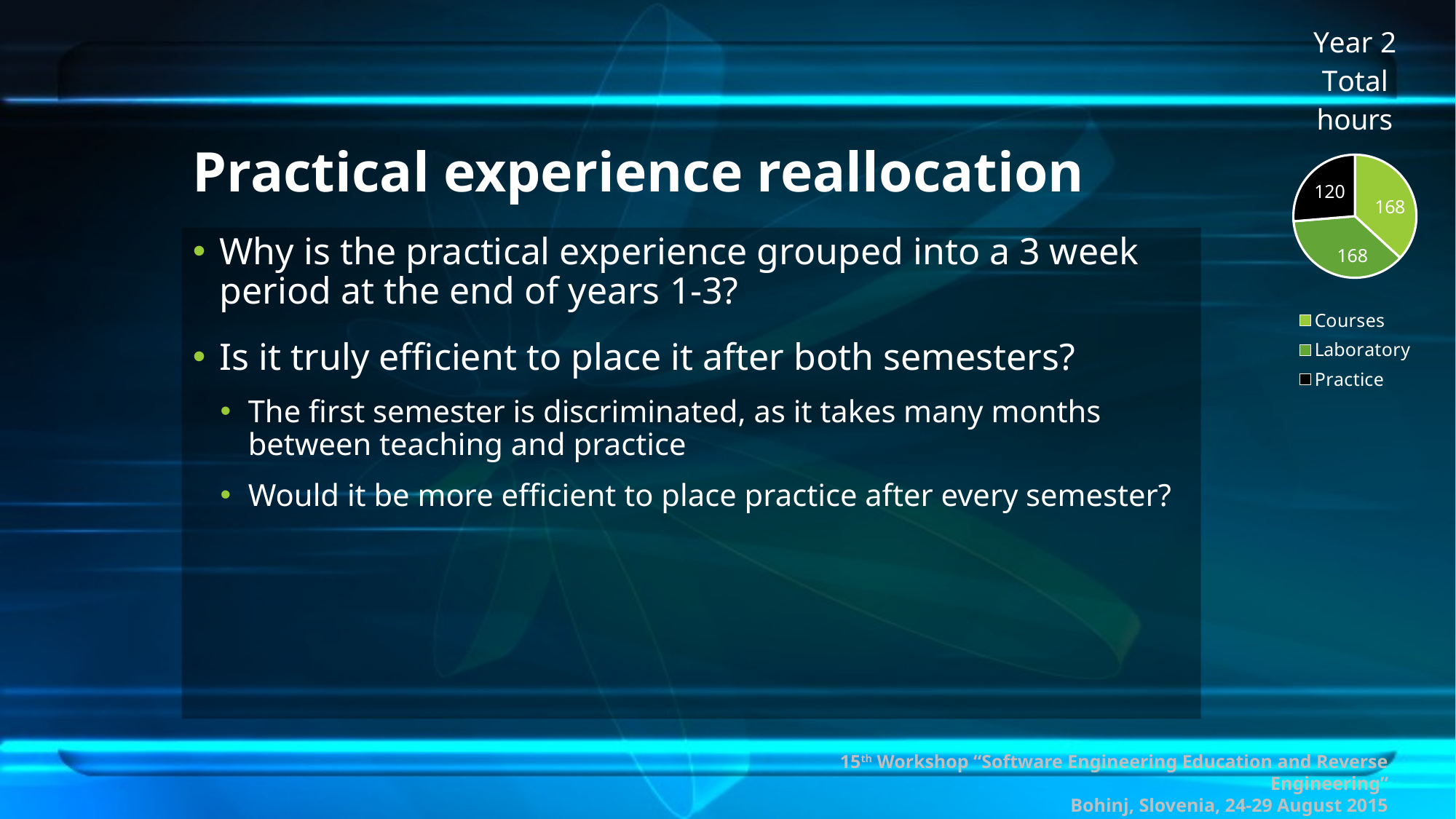
How many entries does the legend of the Year 2 Total hours chart list? 3 How many slices does the Year 2 Total hours pie chart have? 3 What is the value for Laboratory in the Year 2 Total hours pie chart? 168 What is the total of all slices in the Year 2 Total hours pie chart? 456 Which is larger in the Year 2 Total hours chart, Laboratory or Practice? Laboratory Which legend entry in the Year 2 Total hours chart is shown in black? Practice What is the difference between the Courses value and the Practice value in the Year 2 Total hours chart? 48 What is the value for Courses in the Year 2 Total hours pie chart? 168 What kind of chart is shown on the slide? Pie chart Which category has the lowest value in the Year 2 Total hours pie chart? Practice What is the value for Practice in the Year 2 Total hours pie chart? 120 What is the title of the chart on the slide? Year 2 Total hours